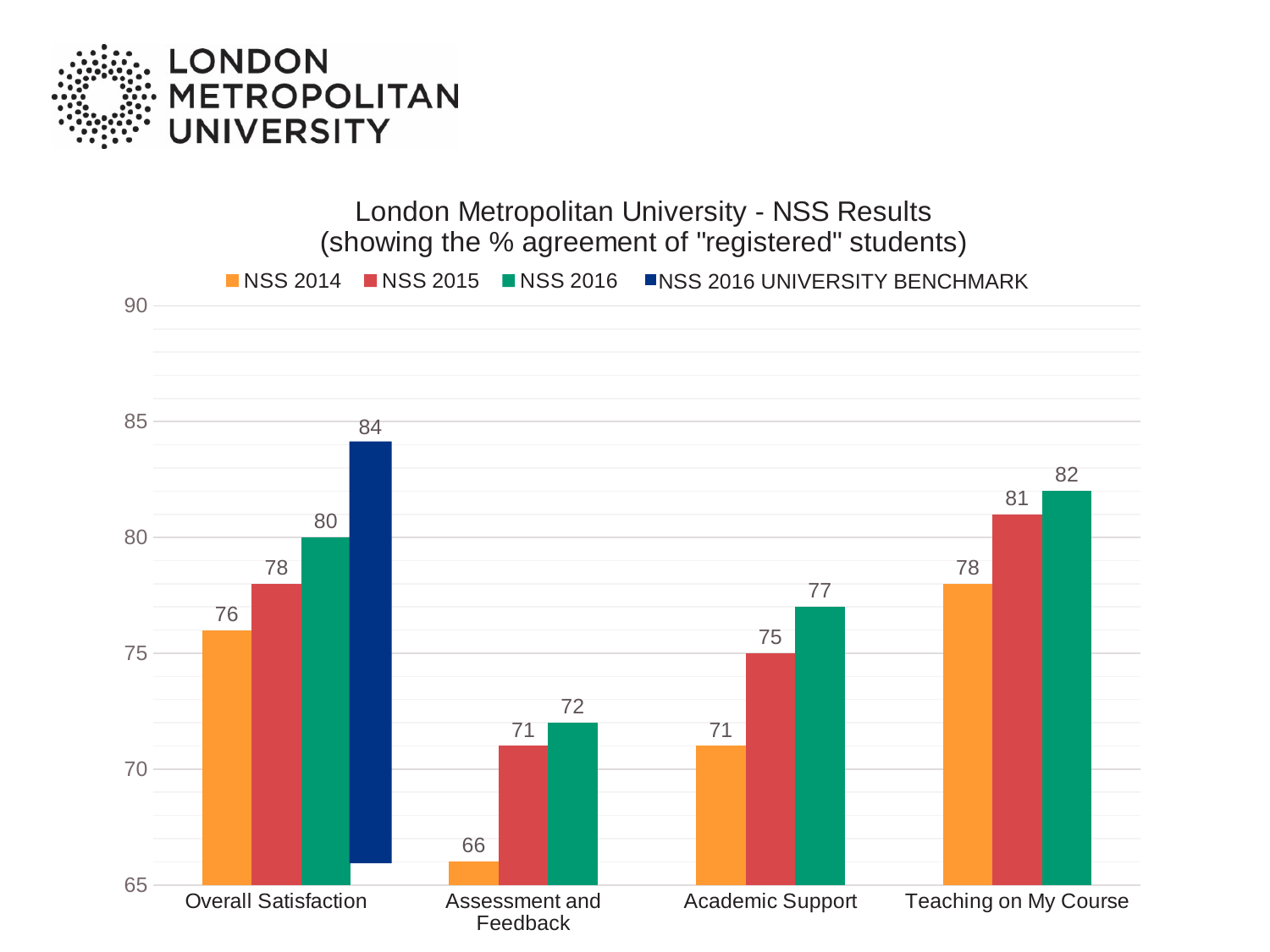
What is the NSS 2016 UNIVERSITY BENCHMARK value for Overall Satisfaction? 84 What kind of chart is shown on the slide? Bar chart How many series does the legend list? 4 Which category has the highest NSS 2016 value? Teaching on My Course How many categories are shown on the x axis? 4 Which is larger for Overall Satisfaction: the NSS 2016 value or the NSS 2016 UNIVERSITY BENCHMARK value? NSS 2016 UNIVERSITY BENCHMARK What is the NSS 2014 value for Assessment and Feedback? 66 What is the difference between the NSS 2016 and NSS 2014 values for Assessment and Feedback? 6 Which category has the lowest NSS 2014 value? Assessment and Feedback Is the NSS 2015 value for Teaching on My Course greater or less than 80? greater What is the NSS 2016 value for Academic Support? 77 Which series is shown in dark blue in the legend? NSS 2016 UNIVERSITY BENCHMARK